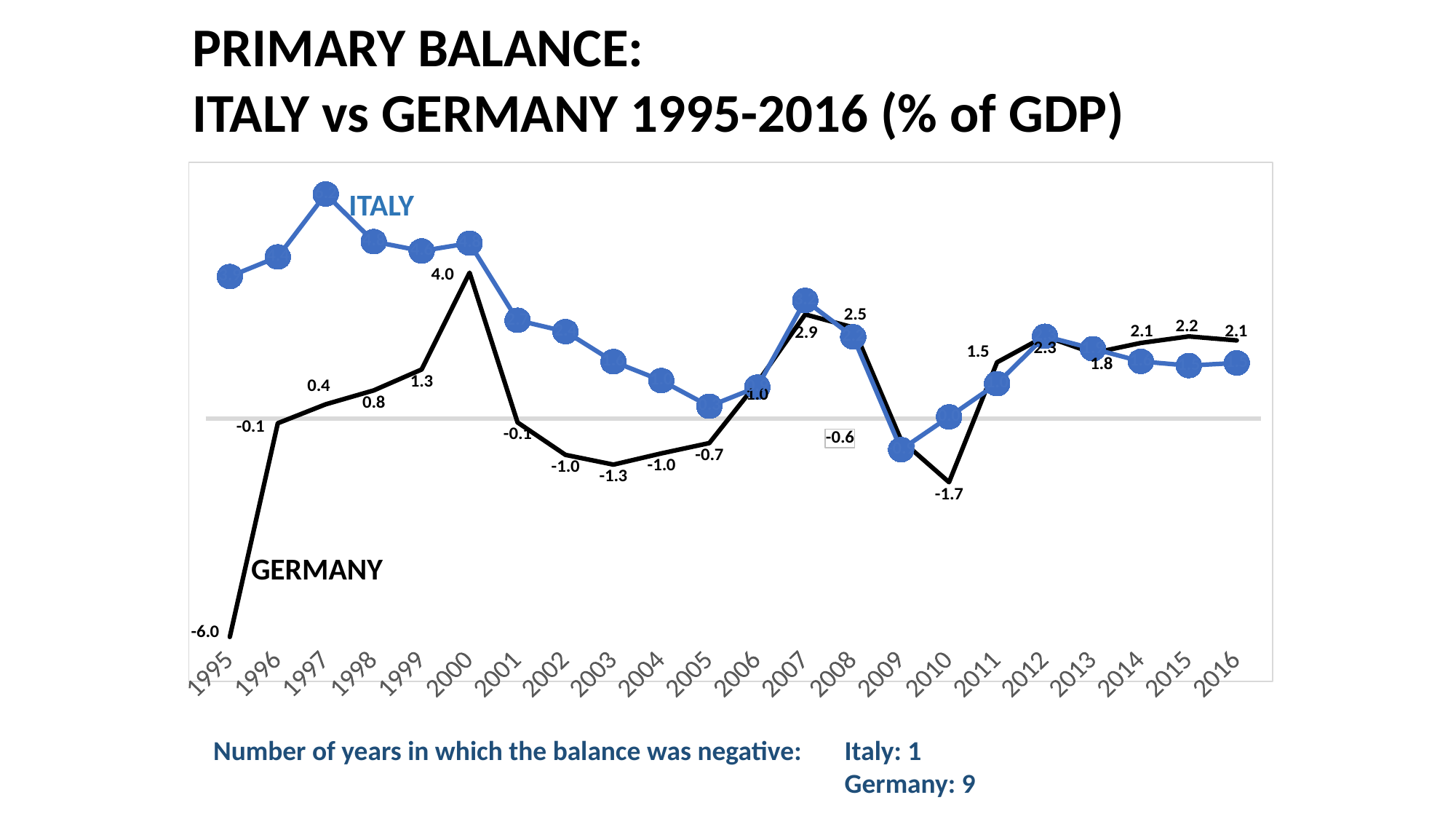
Does Italy's primary balance rise or fall from 2000 to 2005? fall Which is larger, Germany's primary balance in 2007 or in 2008? 2007 In which year was Italy's primary balance highest? 1997 What kind of chart is shown on the slide? line chart What was Germany's primary balance in 2000? 4.0 In which year was Germany's primary balance highest? 2000 What is the difference between Germany's primary balance in 2000 and in 1995? 10.0 How many series are plotted on the chart? 2 In which year was Germany's primary balance lowest? 1995 What was Germany's primary balance in 1995? -6.0 What was Germany's primary balance in 2010? -1.7 How many years are shown on the x axis? 22